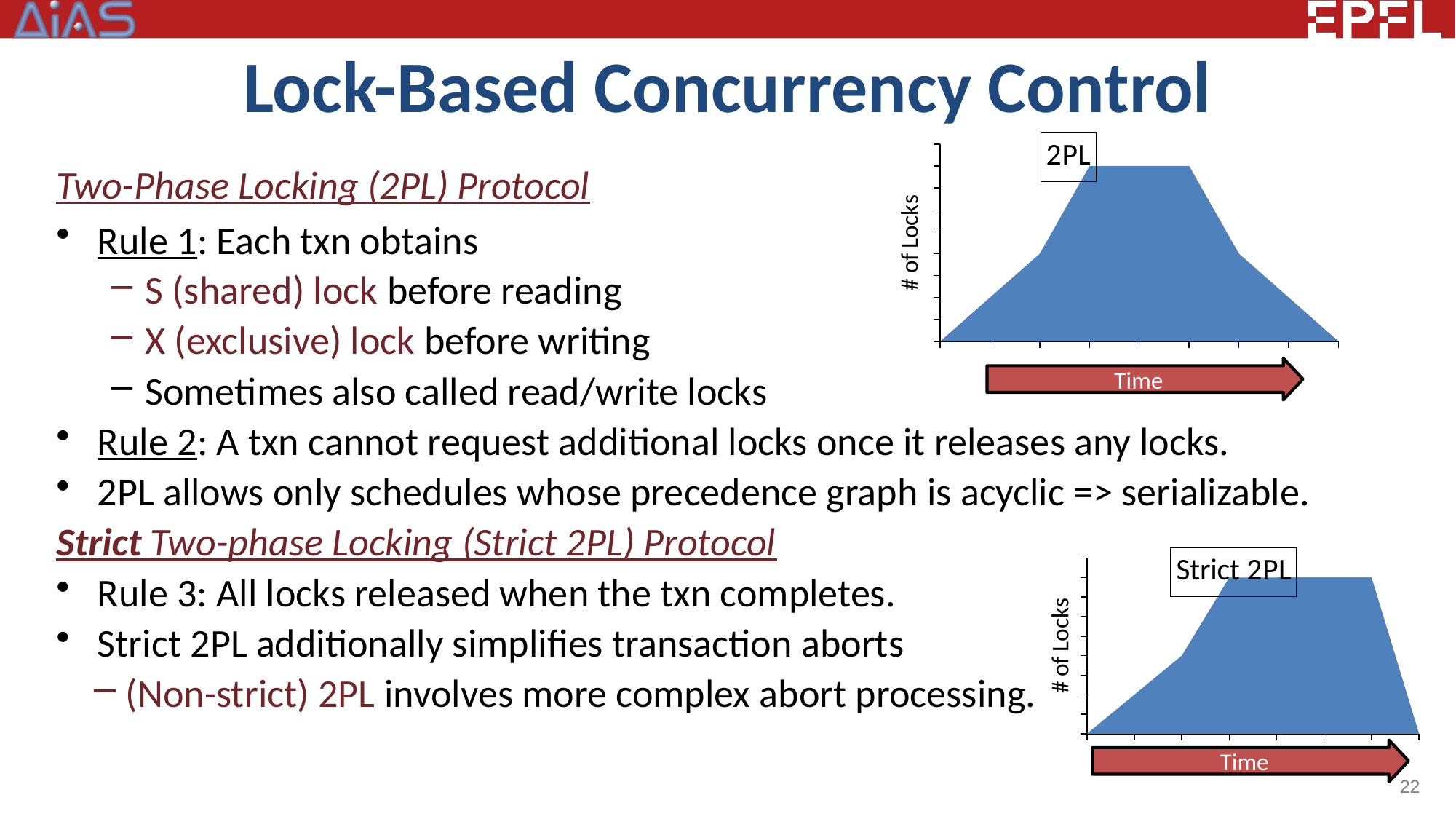
In the "2PL" chart, does the number of locks rise or fall along the last part of the time axis? fall What is the label of the horizontal axis on the "Strict 2PL" chart? Time In the "Strict 2PL" chart, does the number of locks rise or fall at the end of the time axis? fall What is the label of the vertical axis on the "2PL" chart? # of Locks What kind of chart is the chart titled "2PL"? area chart What kind of chart is the chart titled "Strict 2PL"? area chart In the "Strict 2PL" chart, does the number of locks rise or fall at the start of the time axis? rise